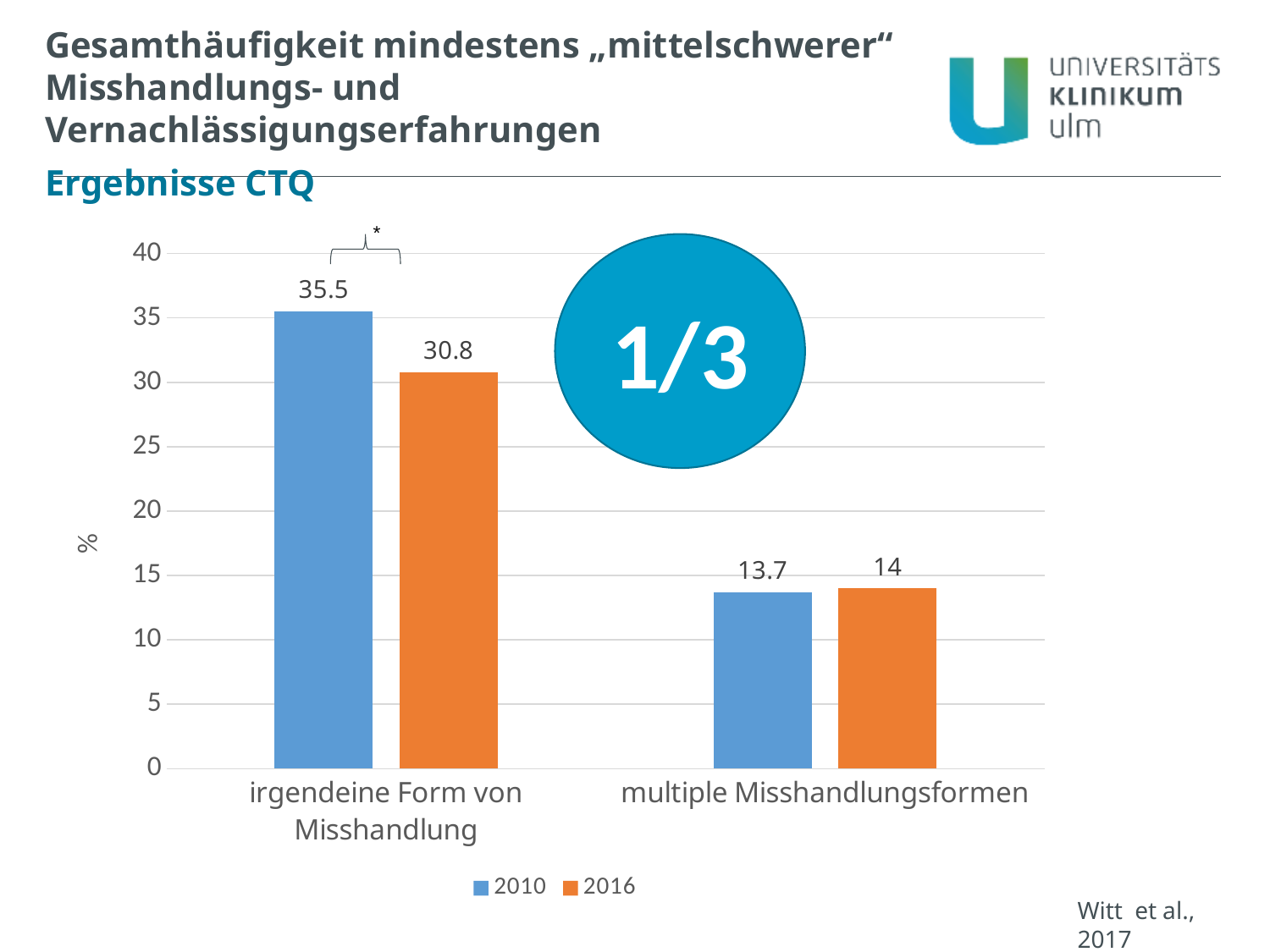
What is the value for 2016 in the category "irgendeine Form von Misshandlung"? 30.8 Which bar has the lowest value on the chart? 2010, multiple Misshandlungsformen What is the value for 2010 in the category "irgendeine Form von Misshandlung"? 35.5 What is the value for 2010 in the category "multiple Misshandlungsformen"? 13.7 How many series does the legend list? 2 How many categories are shown on the x axis? 2 What kind of chart is shown on the slide? bar chart What are the two series listed in the legend? 2010 and 2016 What is the value for 2016 in the category "multiple Misshandlungsformen"? 14 Which bar has the highest value on the chart? 2010, irgendeine Form von Misshandlung For "irgendeine Form von Misshandlung", which year has the larger value, 2010 or 2016? 2010 What is the difference between the 2010 and 2016 values for "irgendeine Form von Misshandlung"? 4.7